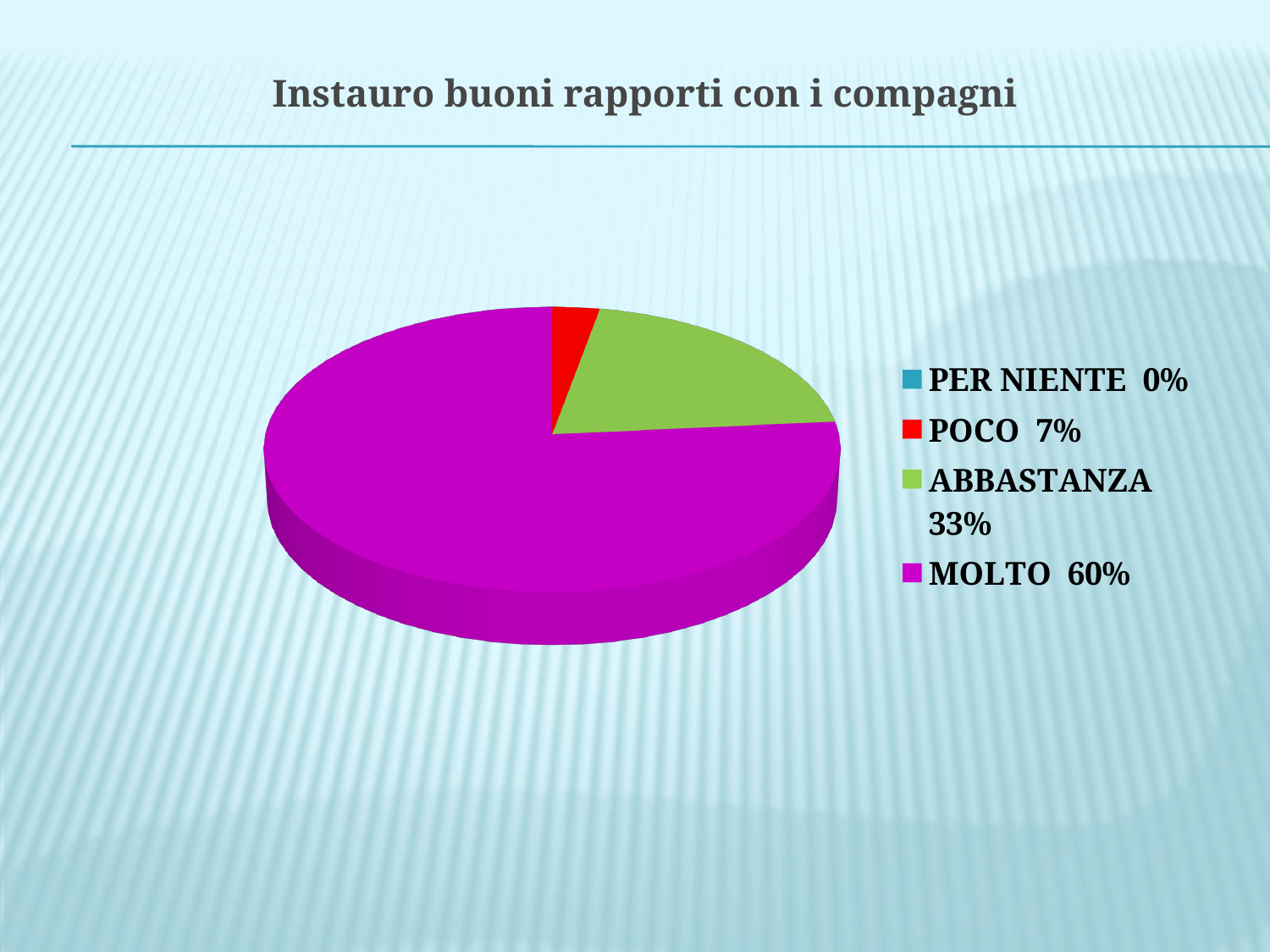
What is the title of the chart? Instauro buoni rapporti con i compagni What type of chart is shown on the slide? pie chart What percentage is shown for MOLTO? 60% What percentage is shown for ABBASTANZA? 33% What percentage is shown for POCO? 7% Which is larger, the share for ABBASTANZA or the share for POCO? ABBASTANZA How many categories does the legend list? 4 What percentage is shown for PER NIENTE? 0% What is the difference in percentage points between MOLTO and ABBASTANZA? 27 Which category has the smallest share of the pie? PER NIENTE Which category has the largest share of the pie? MOLTO What colour is the MOLTO slice? magenta